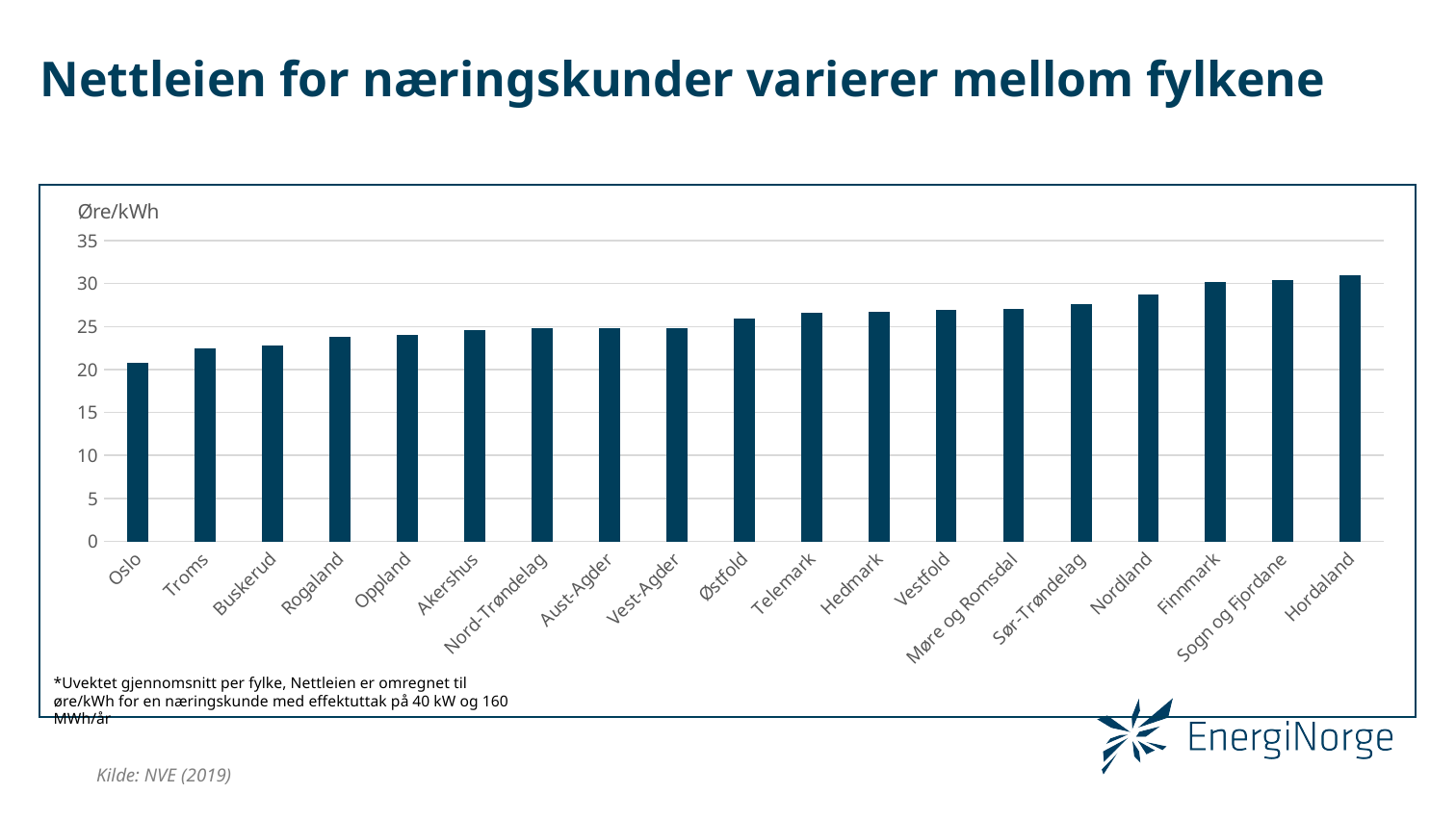
Is the value for Nordland greater or less than 30? less Is the value for Troms greater or less than 25? less What is the title of the slide? Nettleien for næringskunder varierer mellom fylkene Which has the higher value, Oslo or Hordaland? Hordaland What unit is shown on the y axis of the chart? Øre/kWh How many fylker (categories) are shown on the x axis of the chart? 19 Which fylke has the lowest nettleie in the chart? Oslo What kind of chart is shown on the slide? bar chart Which has the higher value, Troms or Nordland? Nordland Do the values rise or fall from left to right along the x axis? rise Is the value for Hordaland greater or less than 30? greater